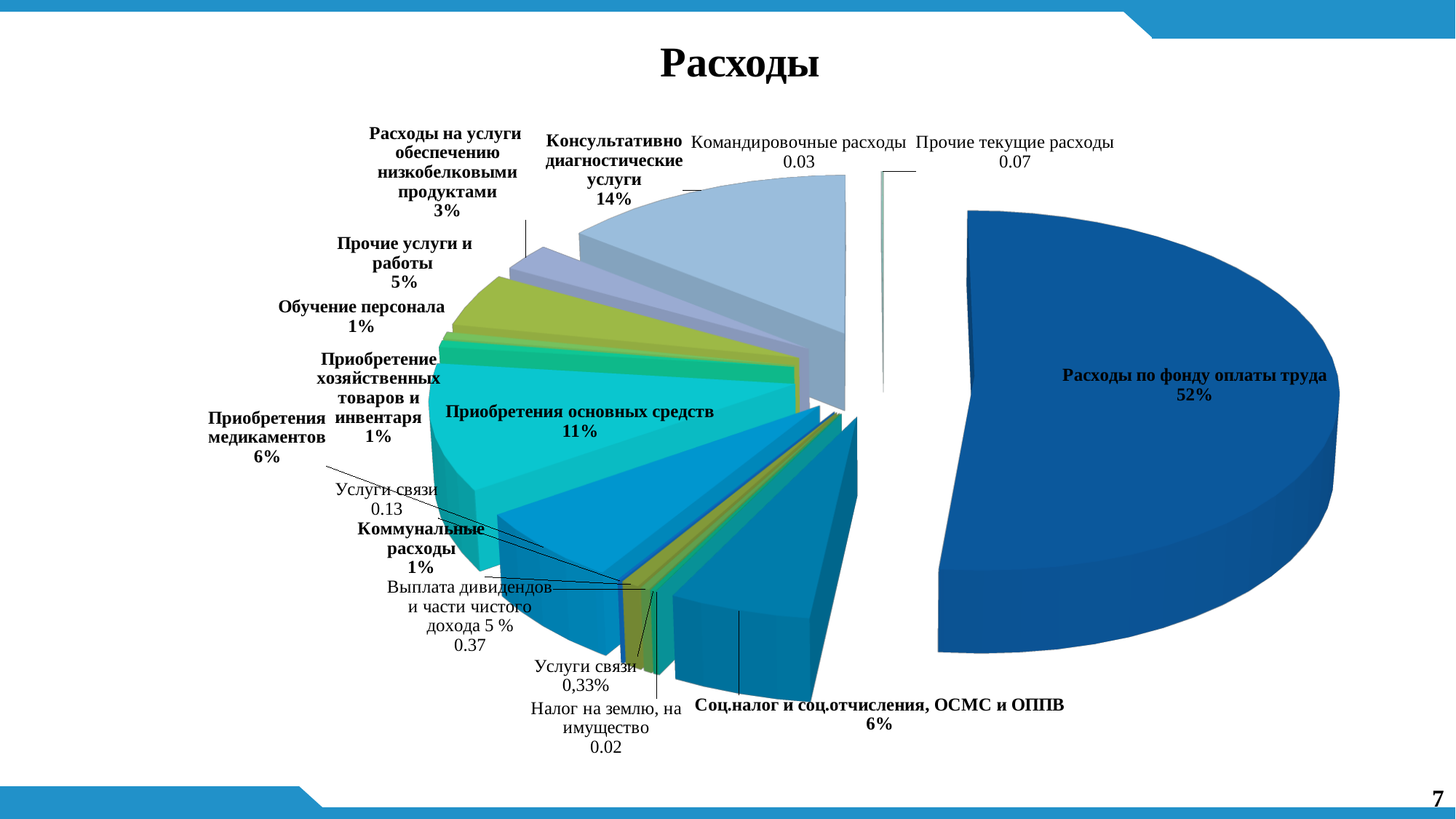
What is the title of the chart? Расходы By how many percentage points does Расходы по фонду оплаты труда exceed Консультативно диагностические услуги? 38 What percentage is shown for Прочие услуги и работы? 5% What percentage is shown for Приобретения основных средств? 11% What value is shown for Командировочные расходы? 0.03 What percentage is shown for Консультативно диагностические услуги? 14% What share of the pie is labelled for Расходы по фонду оплаты труда? 52% What type of chart is shown on the slide? Pie chart Which is larger: Приобретения основных средств or Приобретения медикаментов? Приобретения основных средств Which category has the largest slice of the pie? Расходы по фонду оплаты труда What value is shown for Прочие текущие расходы? 0.07 What percentage is shown for Соц.налог и соц.отчисления, ОСМС и ОППВ? 6%